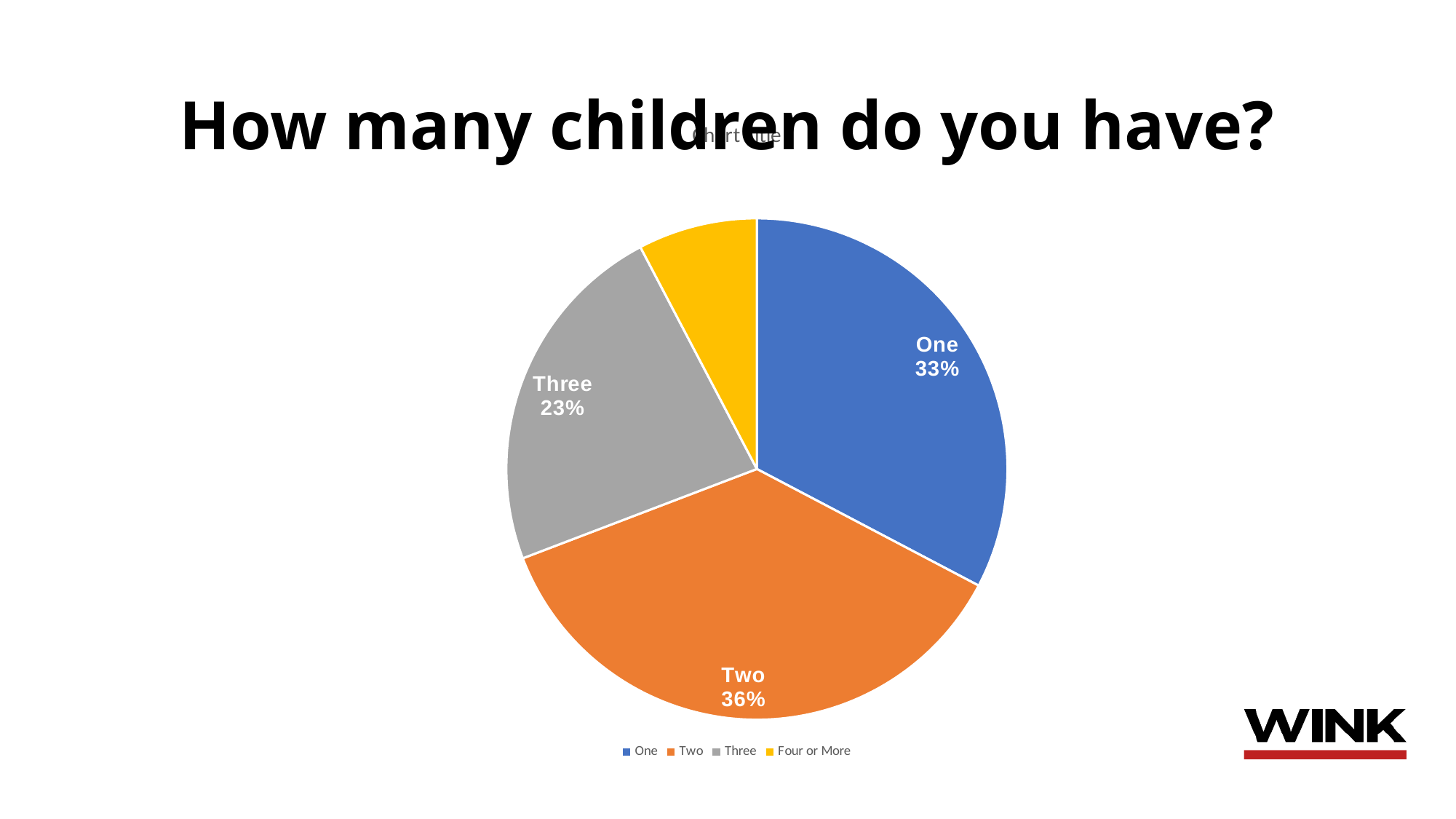
What is the difference in percentage points between the Two and Three slices? 13 Which slice is larger, Three or Four or More? Three What is the difference in percentage points between the Two and One slices? 3 Which category has the smallest share of the pie? Four or More How many categories does the legend list? 4 What percentage of respondents have two children? 36% What colour is the slice for Four or More? yellow Which category has the largest share of the pie? Two What percentage of respondents have one child? 33% Which slice is larger, One or Three? One What percentage of respondents have three children? 23% What type of chart is shown on the slide? pie chart